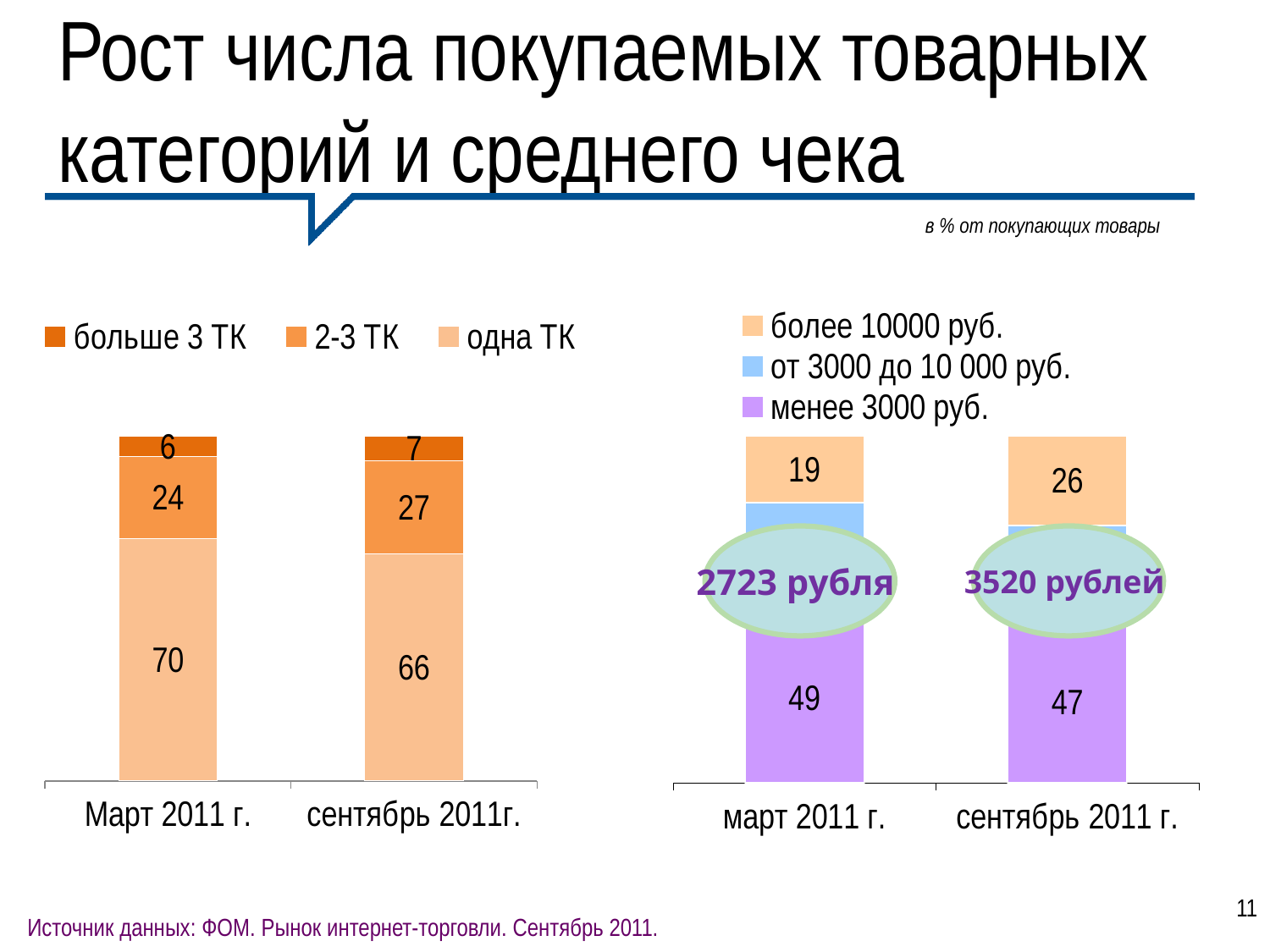
In the right chart, which period has the larger value for 'более 10000 руб.', март 2011 г. or сентябрь 2011 г.? сентябрь 2011 г. In the left chart, what is the value for '2-3 ТК' in сентябрь 2011г.? 27 What average amount in rubles is shown in the oval over the сентябрь 2011 г. bar in the right chart? 3520 рублей In the left chart, what is the value for 'одна ТК' in Март 2011 г.? 70 In the right chart, what is the value for 'менее 3000 руб.' in март 2011 г.? 49 How many series does the legend of the right chart list? 3 In the left chart, what is the value for 'больше 3 ТК' in Март 2011 г.? 6 In the right chart, does the value for 'менее 3000 руб.' rise or fall from март 2011 г. to сентябрь 2011 г.? fall In the left chart, what is the difference between the 'одна ТК' values for Март 2011 г. and сентябрь 2011г.? 4 What kind of chart is the left chart? stacked bar chart In the left chart, what is the total of the stacked bar for сентябрь 2011г.? 100 In the right chart, what is the value for 'более 10000 руб.' in сентябрь 2011 г.? 26